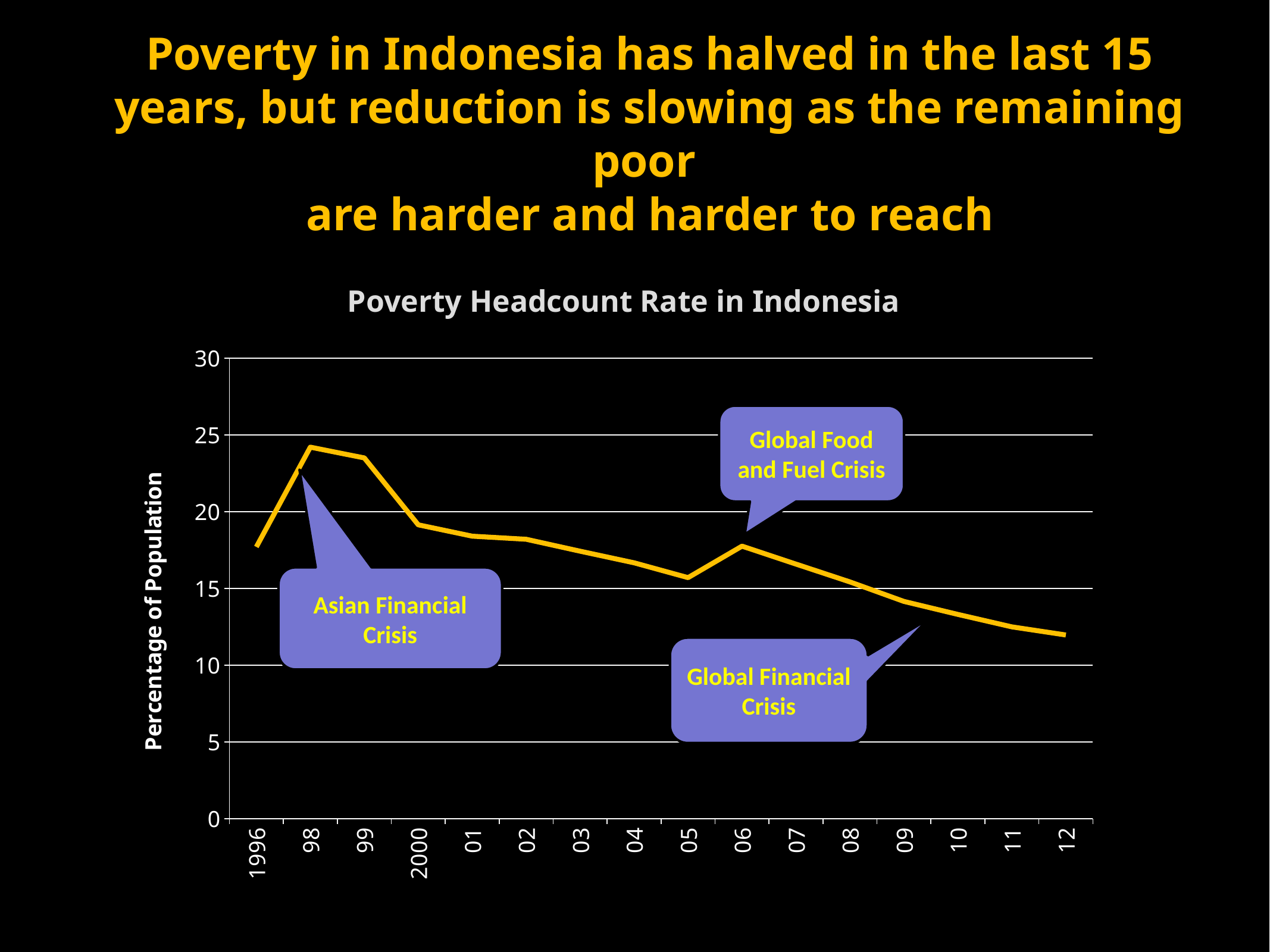
Which event does the callout pointing at the 98 peak label? Asian Financial Crisis Does the poverty headcount rate generally rise or fall from 99 to 12? fall In which year is the poverty headcount rate highest? 98 Is the value for 1996 greater or less than 20? less What kind of chart is shown on the slide? line chart Is the value for 98 greater or less than 20? greater Which year has the higher poverty headcount rate, 05 or 06? 06 How many years are plotted along the x axis? 16 Is the value for 06 greater or less than 20? less What is the title of the chart? Poverty Headcount Rate in Indonesia In which year is the poverty headcount rate lowest? 12